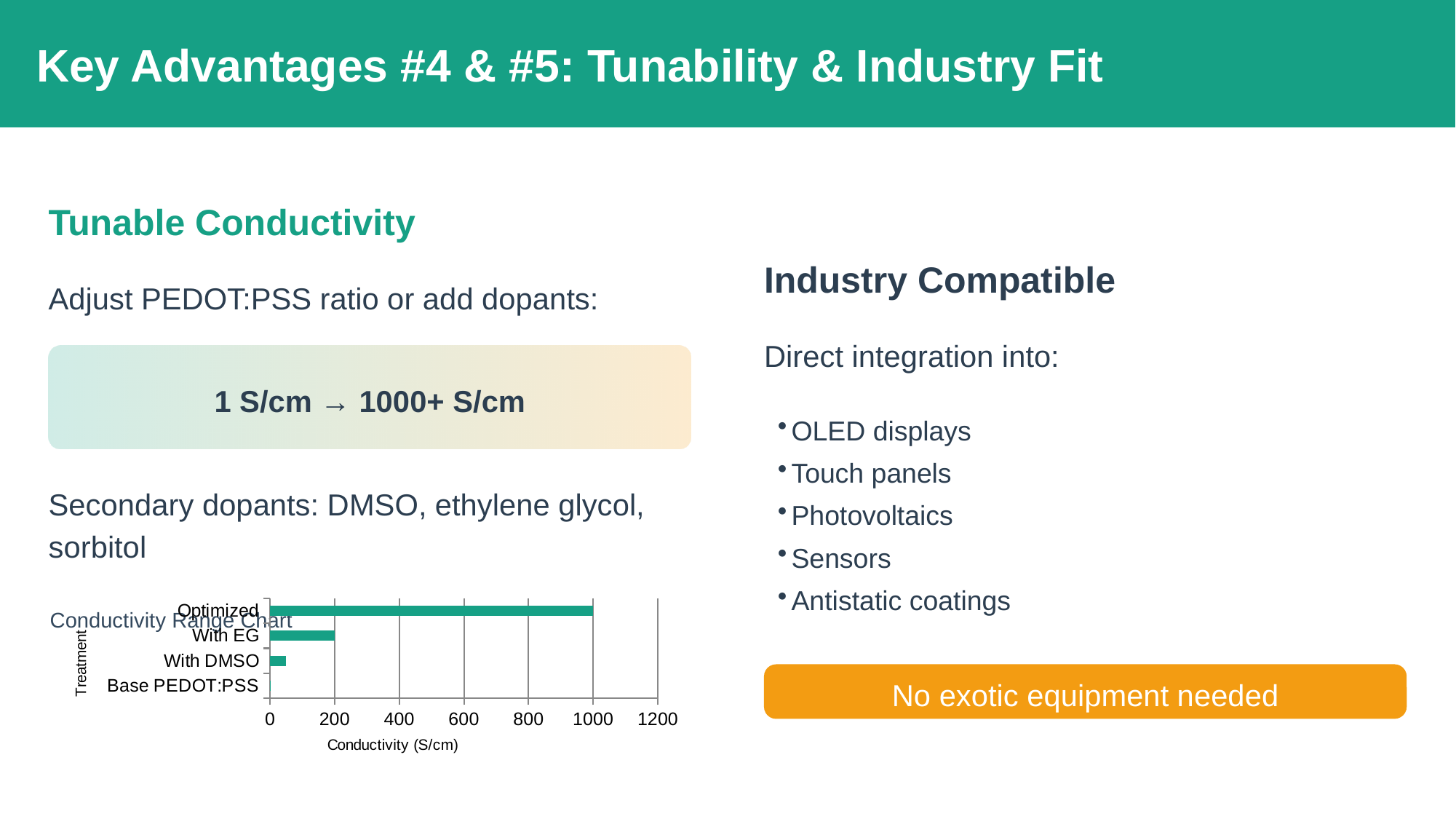
What is the y-axis title of the Conductivity Range Chart? Treatment What is the difference between the Optimized and With EG values in the Conductivity Range Chart? 800 What is the conductivity value for With EG in the Conductivity Range Chart? 200 Is the value for Optimized greater or less than 800 in the Conductivity Range Chart? greater Which treatment has the lowest conductivity in the Conductivity Range Chart? Base PEDOT:PSS How many treatment categories are shown in the Conductivity Range Chart? 4 Is the value for With DMSO greater or less than 200 in the Conductivity Range Chart? less Which treatment has the highest conductivity in the Conductivity Range Chart? Optimized What is the x-axis title of the Conductivity Range Chart? Conductivity (S/cm) What kind of chart is the Conductivity Range Chart? bar chart What is the conductivity value for Optimized in the Conductivity Range Chart? 1000 Which has a higher conductivity in the Conductivity Range Chart, With EG or With DMSO? With EG